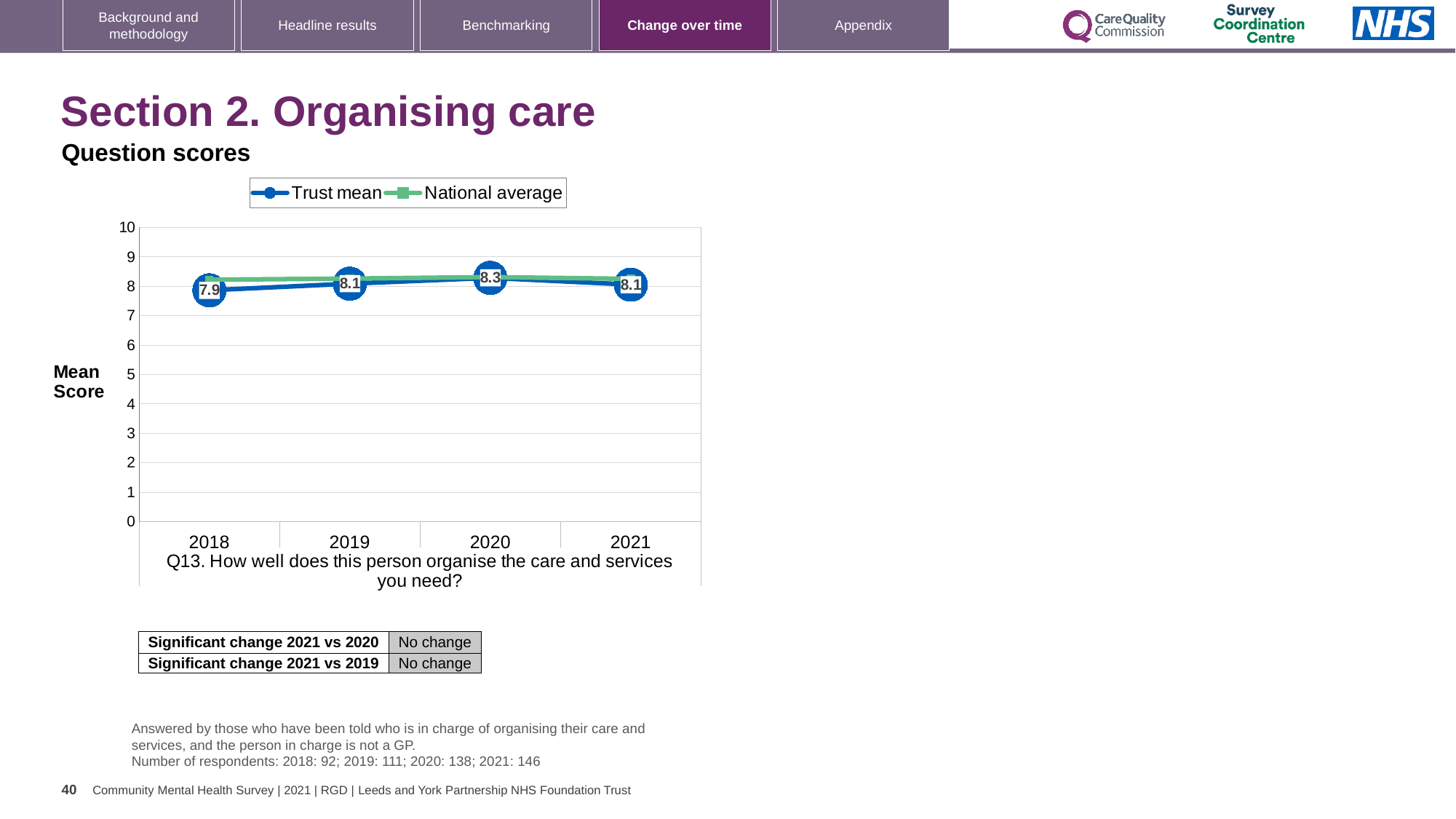
What is the Trust mean score for 2020? 8.3 How many series does the legend list? 2 What kind of chart is shown? line chart What is the Trust mean score for 2018? 7.9 What is the Trust mean score for 2021? 8.1 In which year is the Trust mean lowest? 2018 What is the difference between the Trust mean in 2020 and in 2018? 0.4 Which year has the larger Trust mean, 2018 or 2020? 2020 In which year is the Trust mean highest? 2020 Does the Trust mean rise or fall from 2018 to 2020? rise Is the National average value for 2018 greater or less than 7? greater How many years are plotted on the x axis? 4